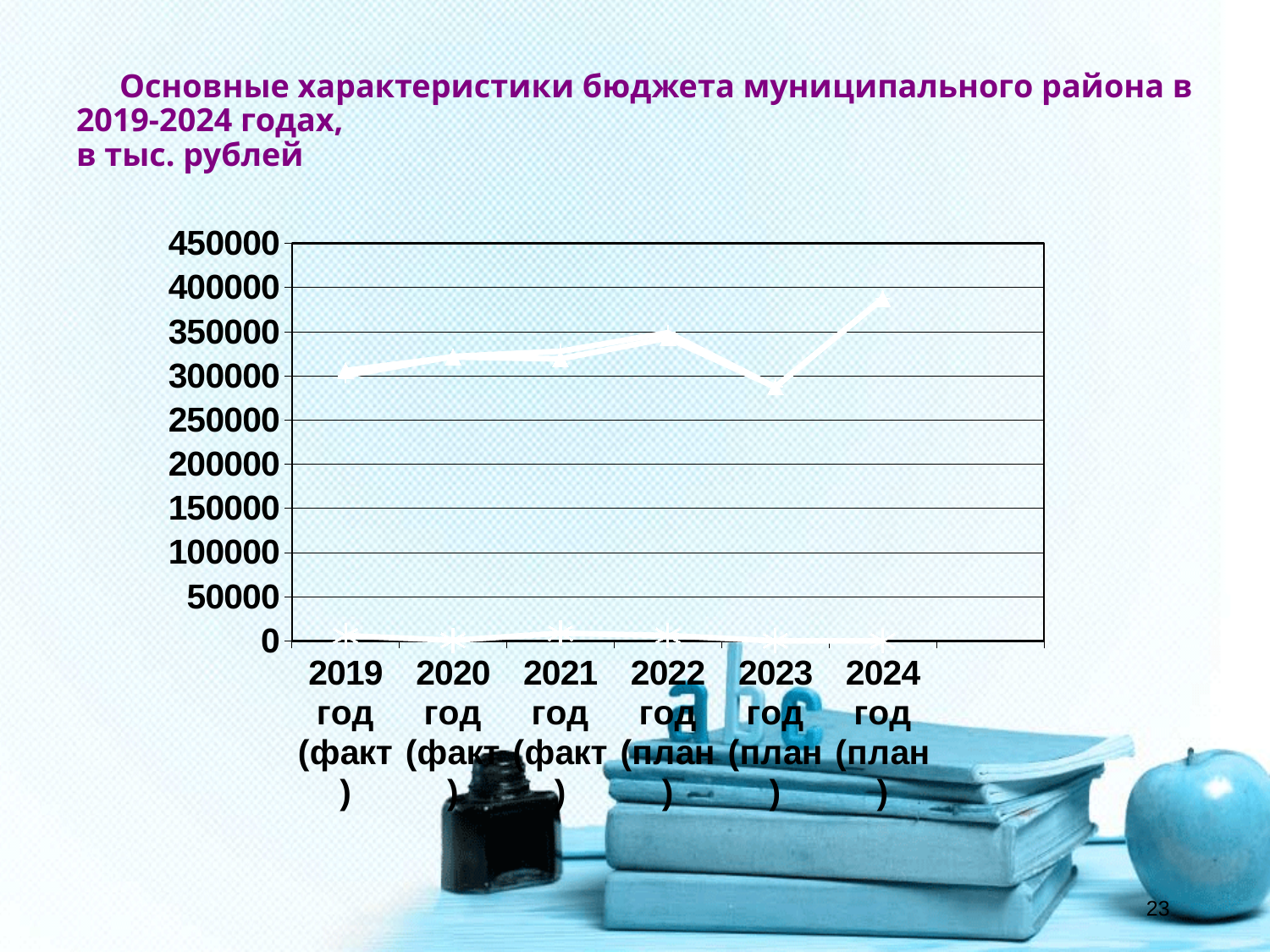
Which year has the highest value on the chart? 2024 год (план) Which is larger, the value for 2024 год (план) or 2023 год (план)? 2024 год (план) Is the value for 2021 год (факт) greater or less than 350000? less Does the upper line rise or fall from 2023 год (план) to 2024 год (план)? rise Is the value for 2023 год (план) greater or less than 300000? less What kind of chart is shown on the slide? line chart How many years (categories) are shown on the x axis of the chart? 6 Which is larger, the value for 2022 год (план) or 2023 год (план)? 2022 год (план) What is the maximum value shown on the vertical axis of the chart? 450000